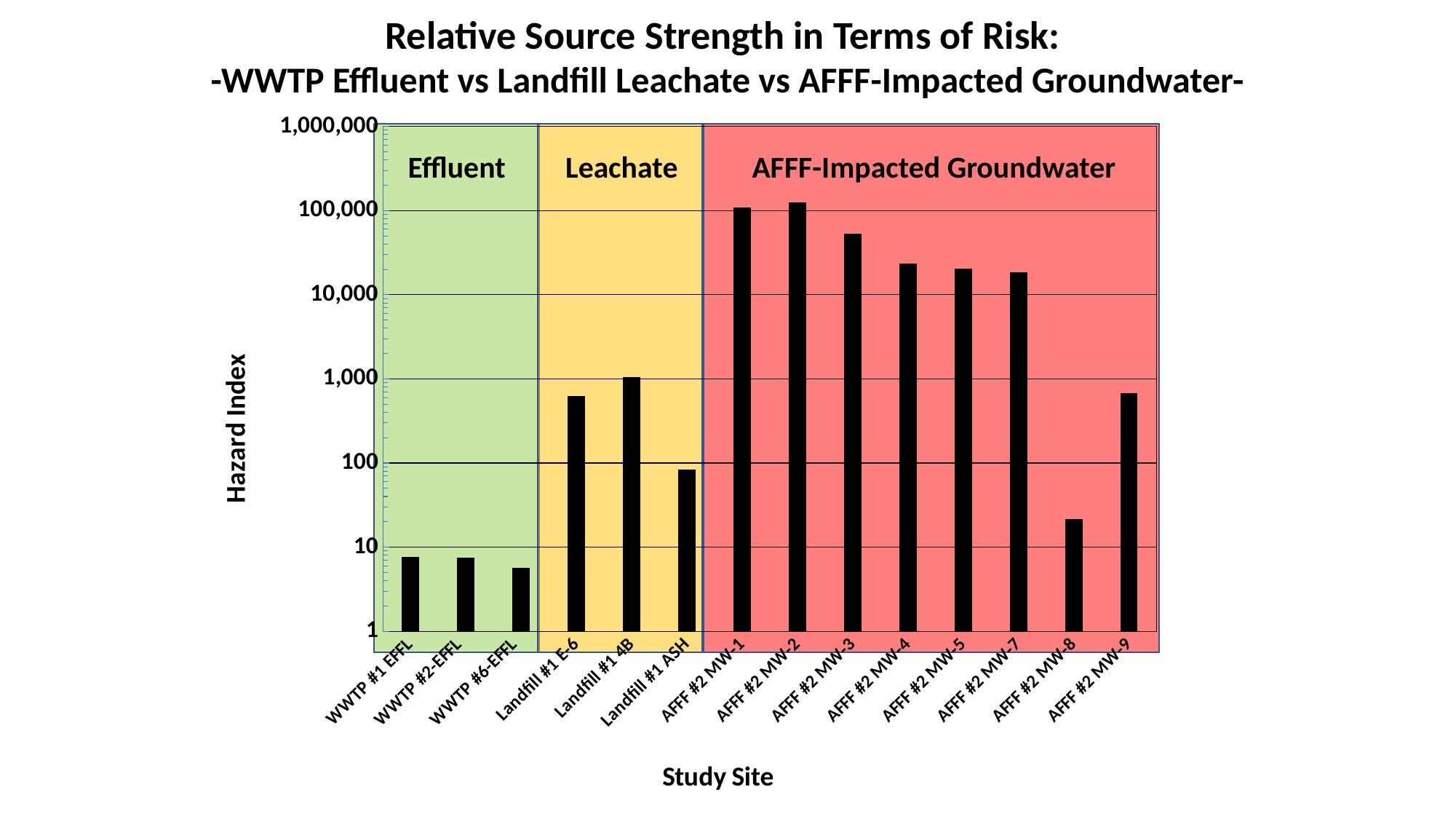
Is the Hazard Index for WWTP #1 EFFL greater or less than 10? less Is the Hazard Index for AFFF #2 MW-3 greater or less than 100,000? less Which study site has the lowest Hazard Index? WWTP #6-EFFL Which study site has the highest Hazard Index? AFFF #2 MW-2 Is the Hazard Index for AFFF #2 MW-8 greater or less than 10? greater Which has the larger Hazard Index, Landfill #1 E-6 or Landfill #1 ASH? Landfill #1 E-6 Which has the larger Hazard Index, AFFF #2 MW-8 or AFFF #2 MW-9? AFFF #2 MW-9 What is the label of the vertical axis? Hazard Index How many study sites (bars) are plotted on the chart? 14 What kind of chart is shown on the slide? bar chart